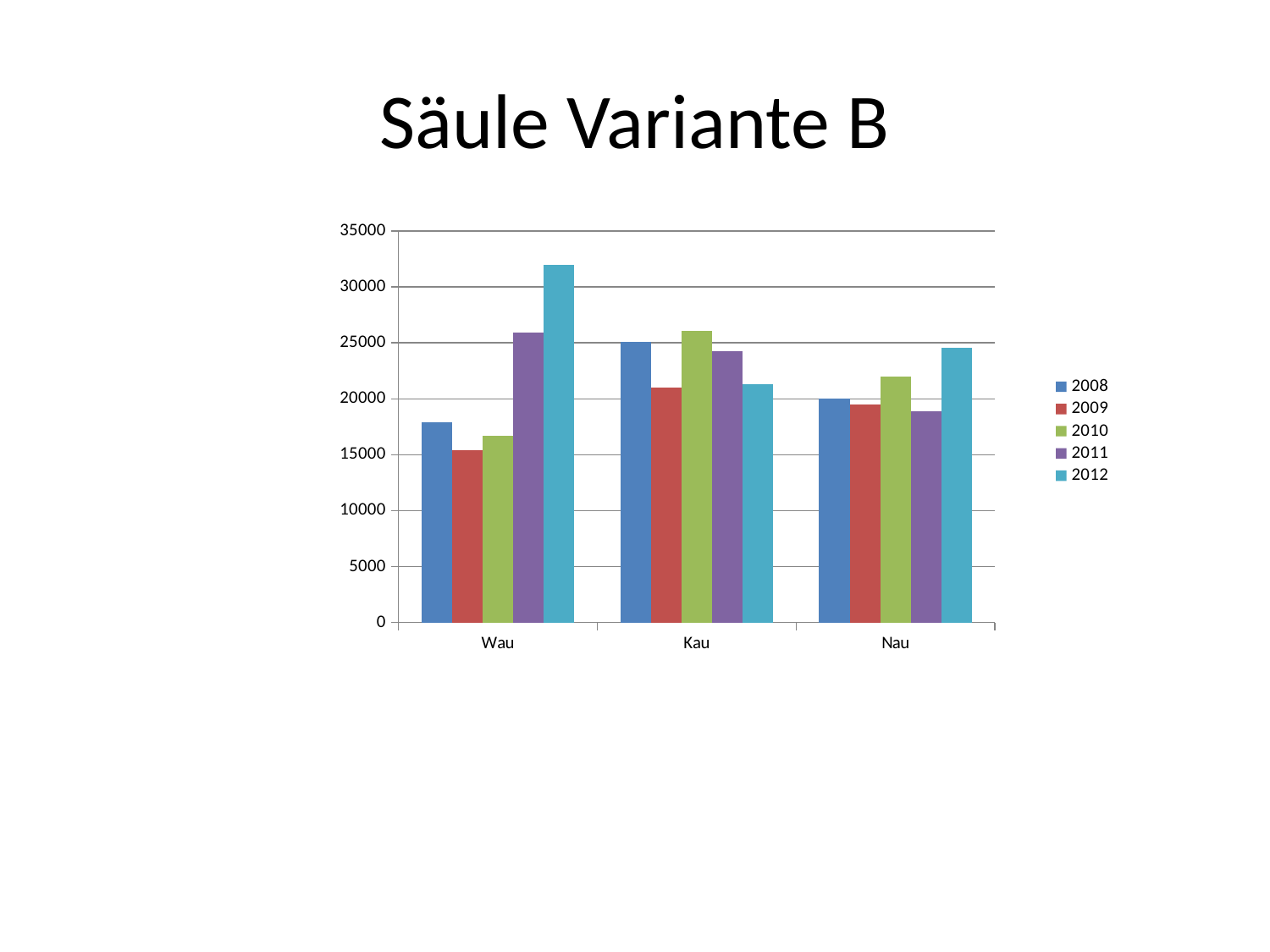
How many series does the legend list? 5 Which series has the lowest value for Kau? 2009 Is the value for 2012 at Wau greater or less than 30000? greater What kind of chart is shown on the slide? bar chart How many categories are shown on the x axis? 3 What is the title of the slide? Säule Variante B Which series has the lowest value for Wau? 2009 Which series has the highest value for Nau? 2012 Is the value for 2009 at Wau greater or less than 20000? less Is the value for 2010 at Kau greater or less than 25000? greater Which series has the highest value for Wau? 2012 Which is larger, the value for 2011 at Wau or the value for 2011 at Nau? 2011 at Wau